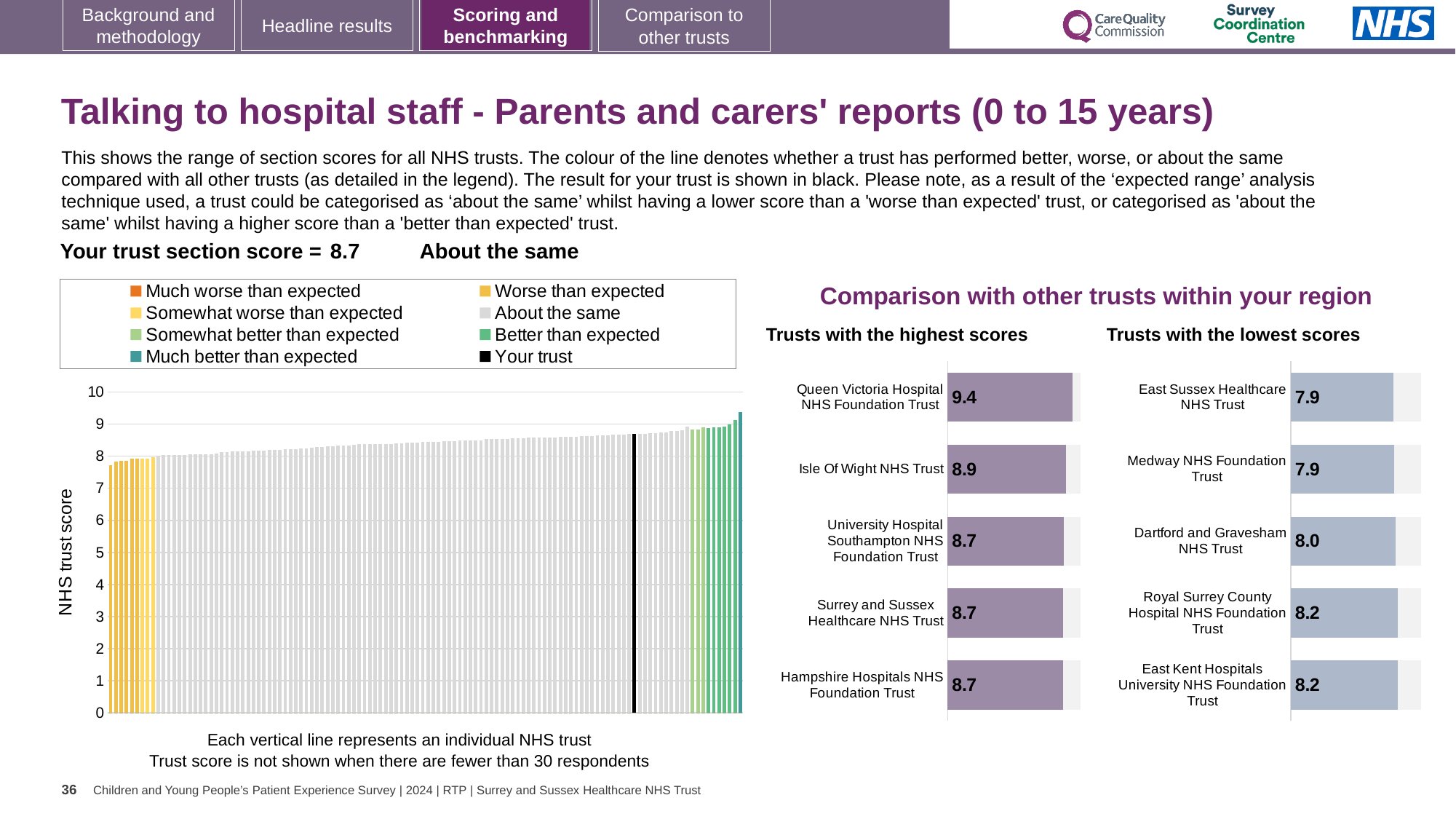
In the 'Trusts with the highest scores' chart, what is the score for Queen Victoria Hospital NHS Foundation Trust? 9.4 What kind of chart is the large chart on the left showing NHS trust scores? Bar chart In the 'Trusts with the highest scores' chart, what is the score for Isle Of Wight NHS Trust? 8.9 Which has the higher score: Isle Of Wight NHS Trust in the highest scores chart or Dartford and Gravesham NHS Trust in the lowest scores chart? Isle Of Wight NHS Trust In the 'Trusts with the lowest scores' chart, what is the score for East Sussex Healthcare NHS Trust? 7.9 In the 'Trusts with the highest scores' chart, what is the difference between the scores of Queen Victoria Hospital NHS Foundation Trust and Isle Of Wight NHS Trust? 0.5 How many entries does the legend of the large chart on the left list? 8 In the 'Trusts with the lowest scores' chart, what is the difference between the scores of Royal Surrey County Hospital NHS Foundation Trust and East Sussex Healthcare NHS Trust? 0.3 In the 'Trusts with the highest scores' chart, which trust has the highest score? Queen Victoria Hospital NHS Foundation Trust In the large chart on the left, do the trust scores rise or fall from left to right? Rise In the 'Trusts with the lowest scores' chart, what is the score for Dartford and Gravesham NHS Trust? 8.0 How many trusts are shown in the 'Trusts with the highest scores' chart? 5